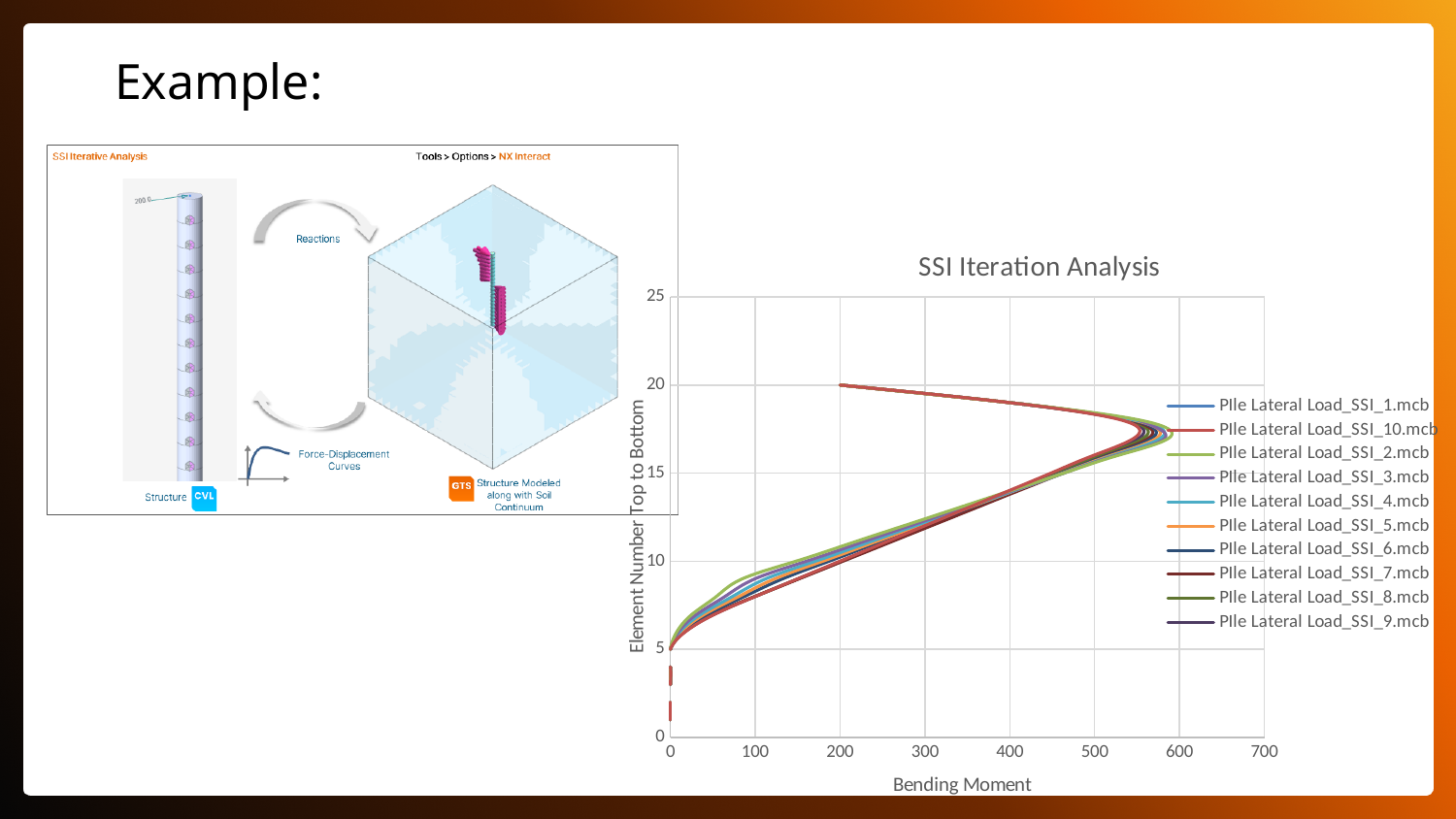
In the SSI Iteration Analysis chart, is the peak bending moment reached by the curves greater or less than 500? greater In the SSI Iteration Analysis chart, at element number 5 is the bending moment greater or less than 100? less What is the highest tick value shown on the x axis of the SSI Iteration Analysis chart? 700 What is the title of the chart on the slide? SSI Iteration Analysis How many series does the legend of the SSI Iteration Analysis chart list? 10 In the SSI Iteration Analysis chart, at element number 10 is the bending moment greater or less than 300? less In the SSI Iteration Analysis chart, does the bending moment rise or fall as the element number increases from 5 to 15? rise In the SSI Iteration Analysis chart, does the bending moment rise or fall as the element number increases from 18 to 20? fall What is the label of the x axis of the SSI Iteration Analysis chart? Bending Moment What kind of chart is the SSI Iteration Analysis chart? line chart